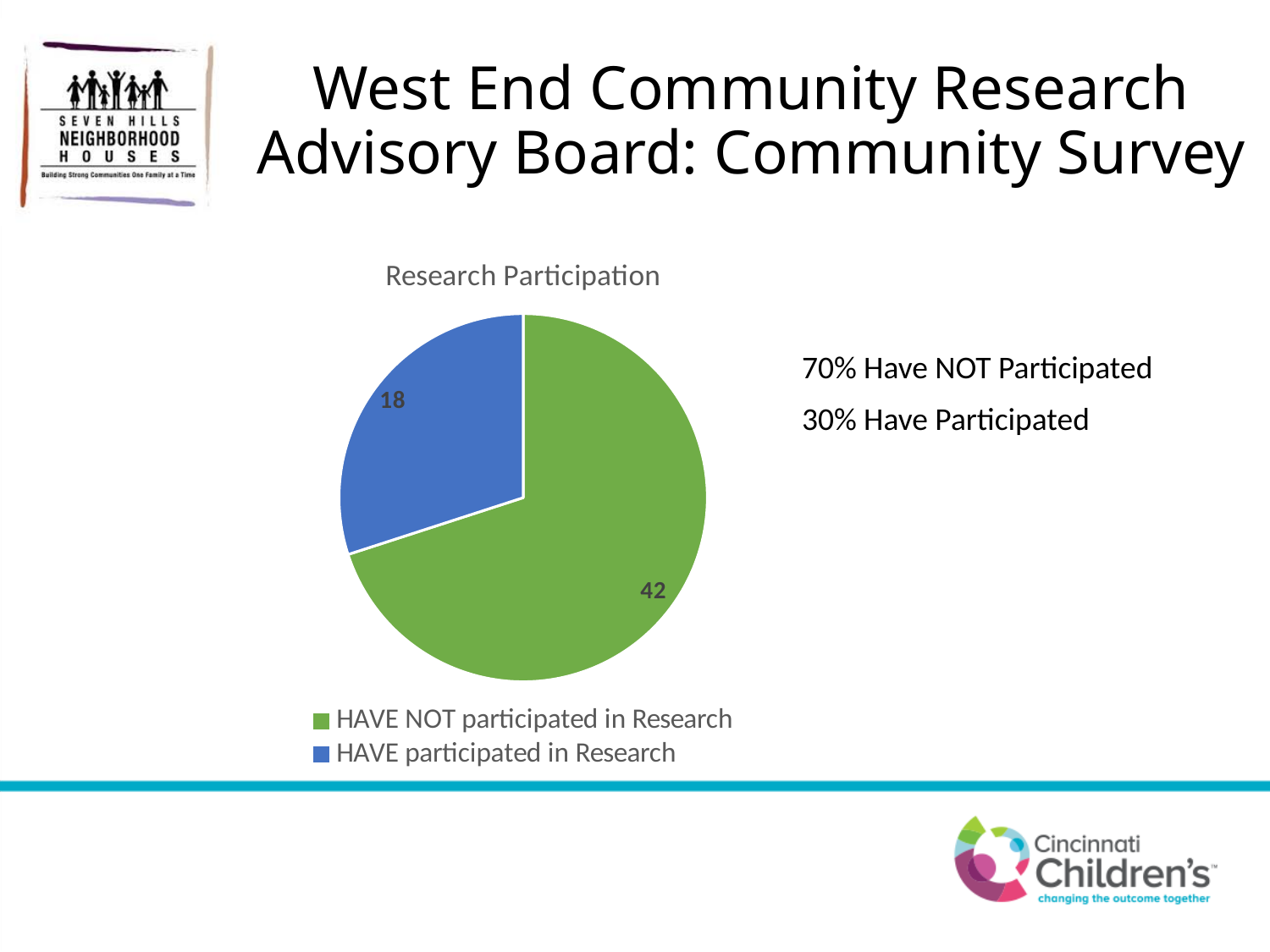
Which category has the smallest slice? HAVE participated in Research What is the total of the two slices in the pie chart? 60 What is the difference between the HAVE NOT participated and HAVE participated values? 24 What share of the pie does HAVE participated in Research represent? 30% How many entries does the legend list? 2 What is the title of the chart? Research Participation What type of chart is shown on the slide? pie chart Which is larger: HAVE participated in Research or HAVE NOT participated in Research? HAVE NOT participated in Research What is the value for HAVE participated in Research? 18 What is the value for HAVE NOT participated in Research? 42 How many slices does the pie chart have? 2 Which category has the largest slice? HAVE NOT participated in Research